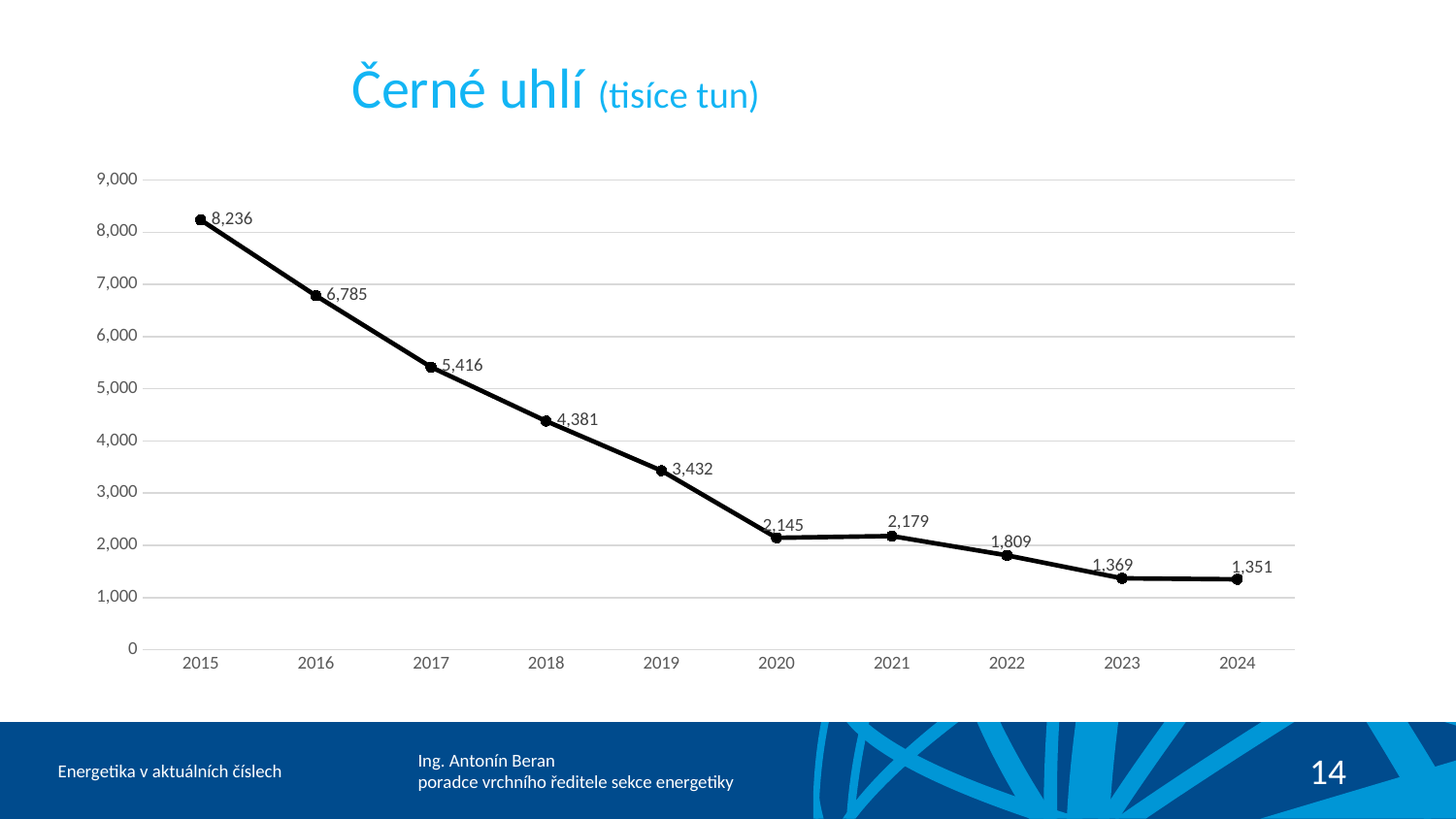
Which is larger, the value for 2020 or the value for 2021? 2021 What kind of chart is shown on the slide? line chart What is the value for 2024? 1,351 What is the overall trend of the values from 2015 to 2024? falling What is the value for 2020? 2,145 What is the difference between the values for 2015 and 2016? 1,451 What is the difference between the values for 2021 and 2020? 34 Which year has the lowest value? 2024 Is the value for 2018 greater or less than 4,000? greater What is the value for 2015? 8,236 Which year has the highest value? 2015 How many years are plotted on the chart? 10